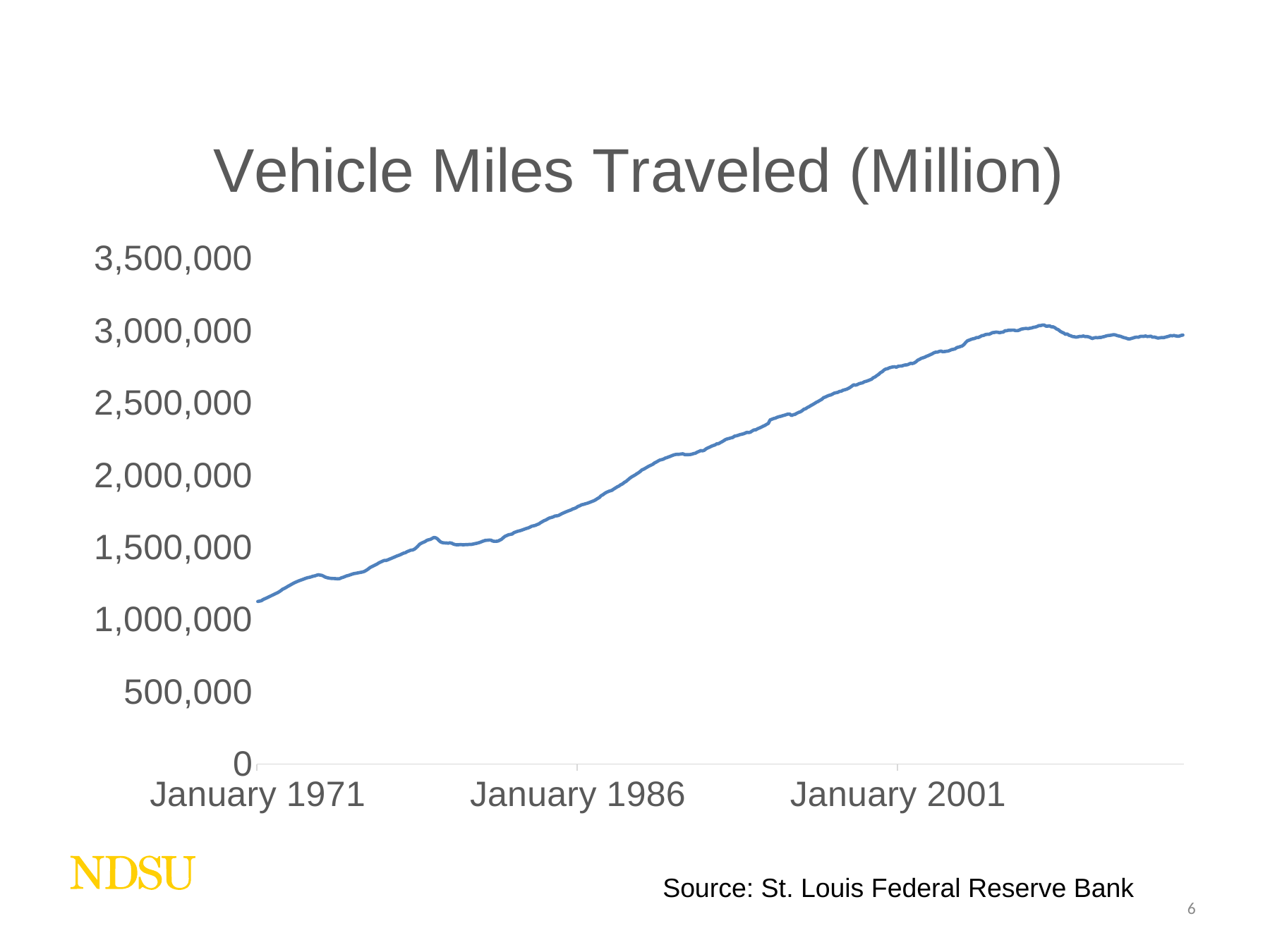
Is the value at January 1986 greater or less than 2,000,000? less Is the value at January 1986 greater or less than 1,500,000? greater What kind of chart is shown on the slide? line chart Is the value at January 2001 greater or less than 2,500,000? greater How many date labels are shown on the x axis? 3 What is the title of the chart? Vehicle Miles Traveled (Million) Which is larger, the value at January 1971 or the value at January 1986? January 1986 Overall, do the values rise or fall from January 1971 to the end of the series? rise Which is larger, the value at January 1986 or the value at January 2001? January 2001 What source is cited for the chart data? St. Louis Federal Reserve Bank